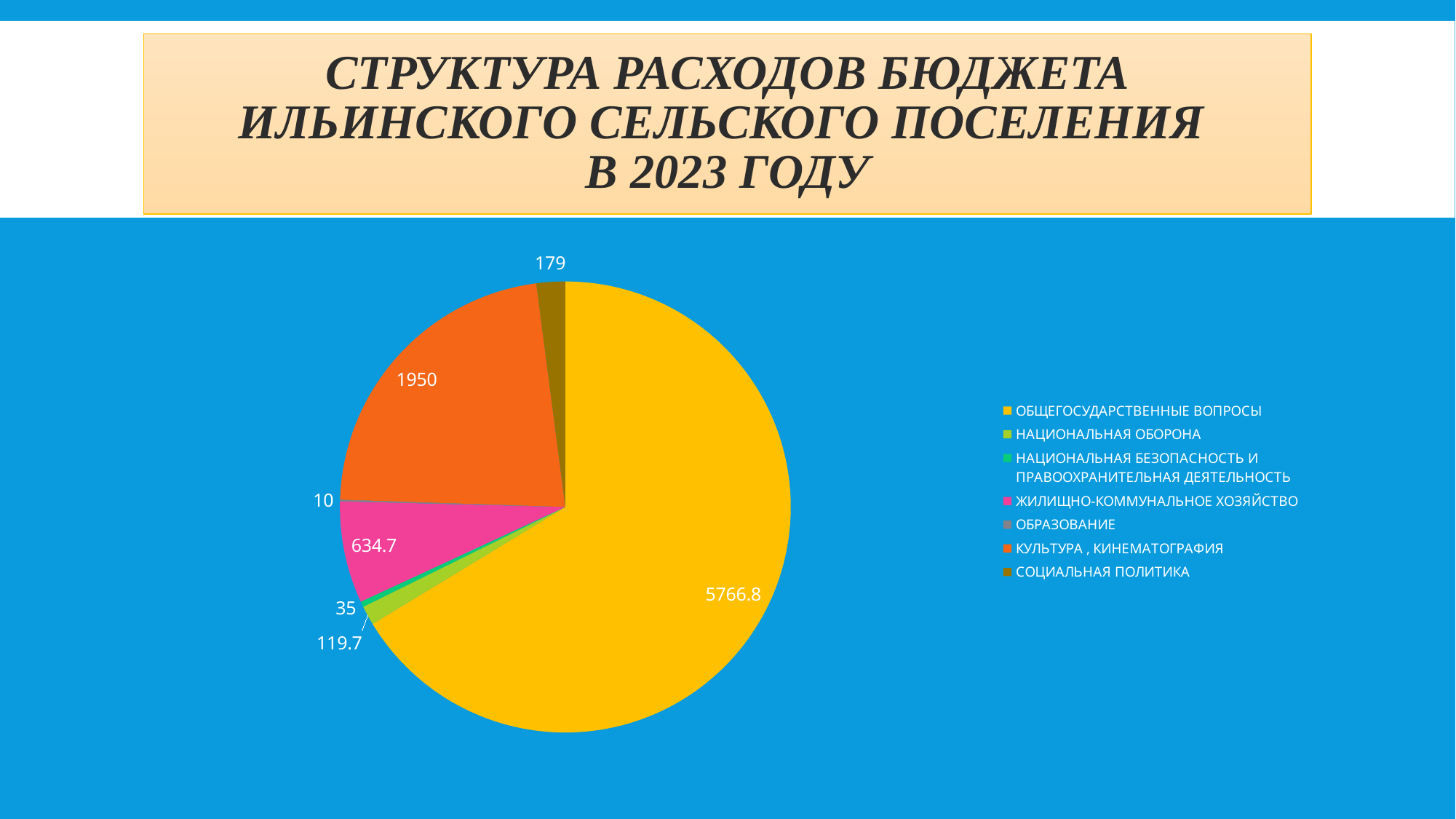
What is the difference between the values for КУЛЬТУРА , КИНЕМАТОГРАФИЯ and ЖИЛИЩНО-КОММУНАЛЬНОЕ ХОЗЯЙСТВО? 1315.3 What is the value for КУЛЬТУРА , КИНЕМАТОГРАФИЯ? 1950 What is the value for ОБЩЕГОСУДАРСТВЕННЫЕ ВОПРОСЫ? 5766.8 Which category has the largest slice of the pie? ОБЩЕГОСУДАРСТВЕННЫЕ ВОПРОСЫ What is the value for СОЦИАЛЬНАЯ ПОЛИТИКА? 179 What is the total of all the values shown on the pie chart? 8695.2 What type of chart is shown on the slide? pie chart What is the value for ЖИЛИЩНО-КОММУНАЛЬНОЕ ХОЗЯЙСТВО? 634.7 What is the value for НАЦИОНАЛЬНАЯ ОБОРОНА? 119.7 Which category has the smallest value? ОБРАЗОВАНИЕ How many categories does the legend list? 7 Which is larger, the value for СОЦИАЛЬНАЯ ПОЛИТИКА or the value for НАЦИОНАЛЬНАЯ ОБОРОНА? СОЦИАЛЬНАЯ ПОЛИТИКА